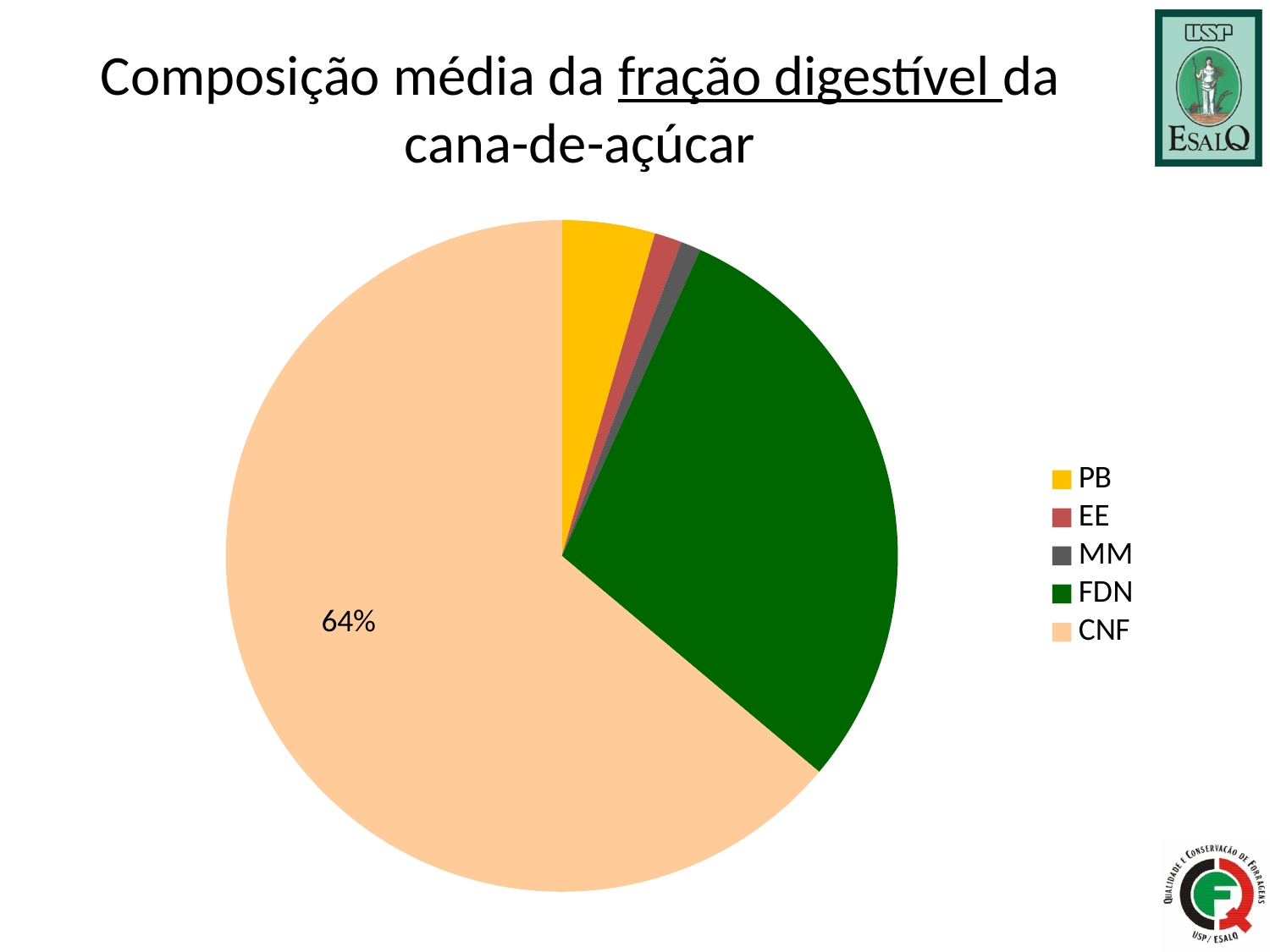
How many entries does the legend list? 5 Which category has the largest slice in the pie chart? CNF What is the title of the slide containing the chart? Composição média da fração digestível da cana-de-açúcar What kind of chart is shown on the slide? Pie chart Which slice is larger, CNF or FDN? CNF What percentage share does the CNF slice have in the pie chart? 64% Is the share of CNF greater or less than 50%? greater Which slice is larger, FDN or PB? FDN What colour is the FDN slice in the pie chart? Green Which slice is larger, PB or MM? PB How many slices does the pie chart have? 5